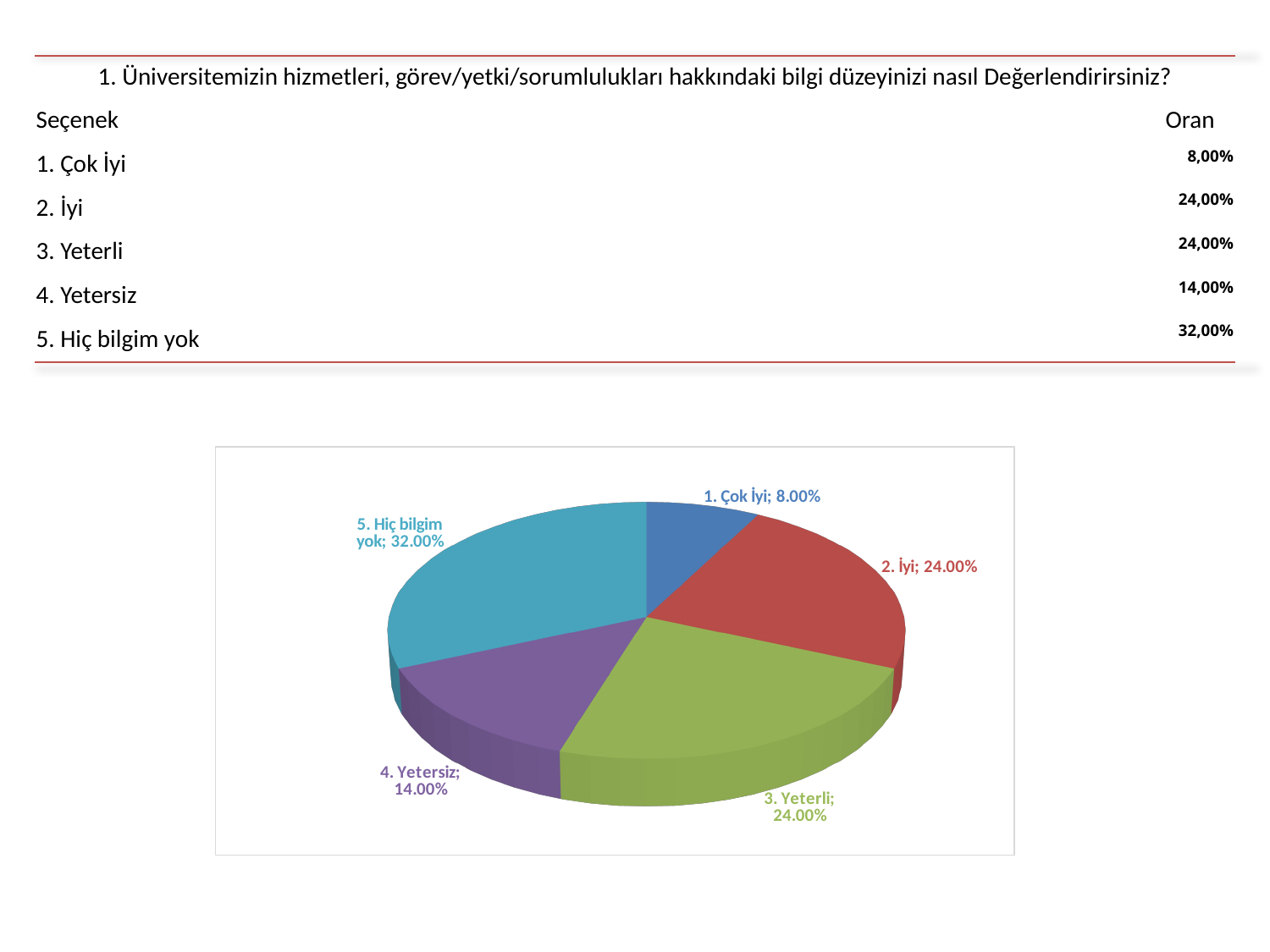
What is the value shown for "1. Çok İyi" in the pie chart? 8.00% What is the difference between the values for "5. Hiç bilgim yok" and "4. Yetersiz" in the pie chart? 18.00% What share of the pie does "3. Yeterli" represent? 24.00% Which category has the largest slice in the pie chart? 5. Hiç bilgim yok What is the value shown for "2. İyi" in the pie chart? 24.00% What is the value shown for "5. Hiç bilgim yok" in the pie chart? 32.00% Which category has the smallest slice in the pie chart? 1. Çok İyi What kind of chart is shown on the slide? pie chart How many slices does the pie chart have? 5 What colour is the slice for "4. Yetersiz" in the pie chart? purple Which is larger in the pie chart: the value for "3. Yeterli" or the value for "4. Yetersiz"? 3. Yeterli What is the value shown for "4. Yetersiz" in the pie chart? 14.00%